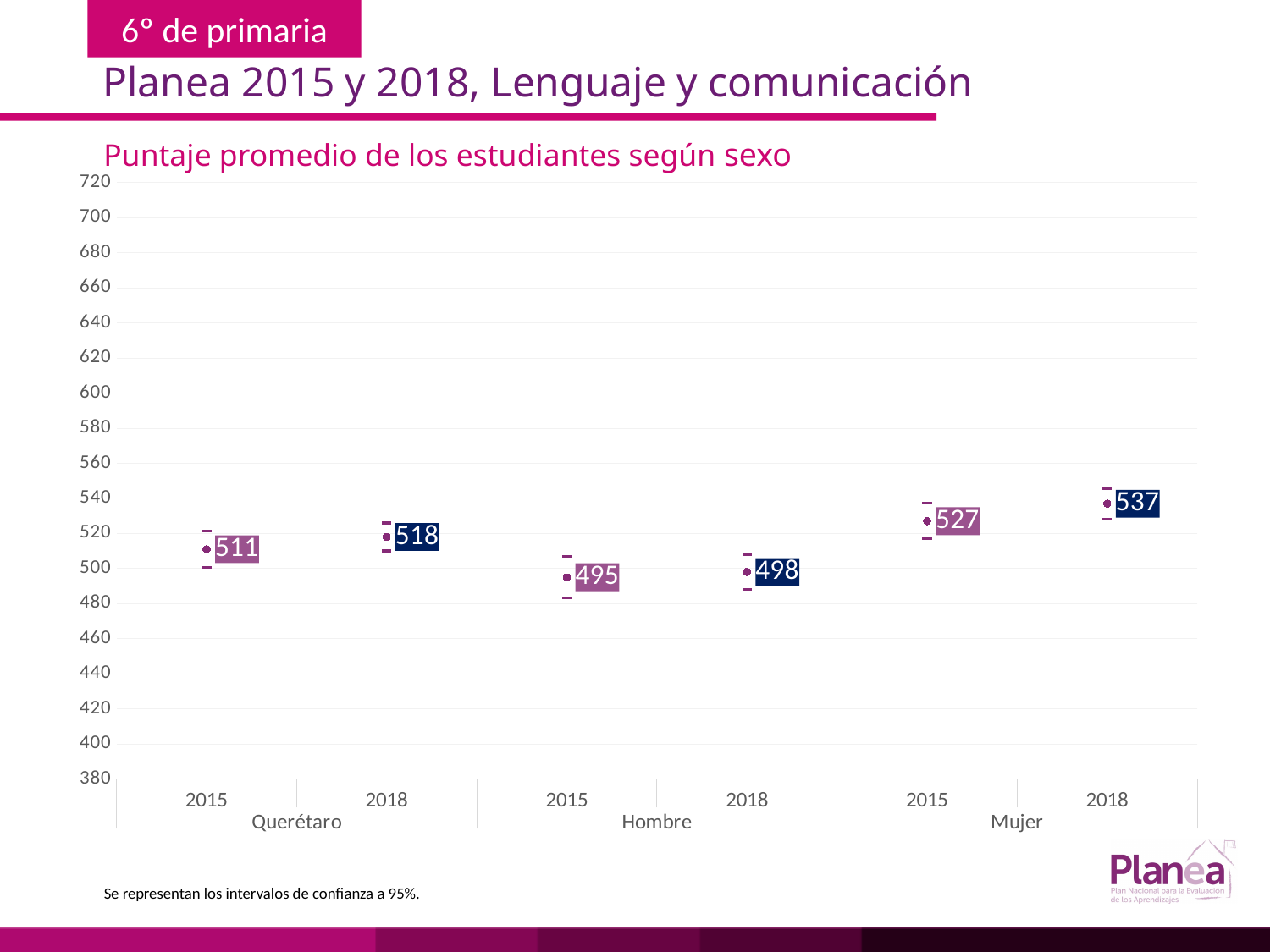
What is the average score for Mujer in 2018? 537 Which group and year has the lowest average score? Hombre 2015 What is the difference between the Mujer scores in 2018 and 2015? 10 Do the scores rise or fall from 2015 to 2018 for each group? rise Is the value for Hombre in 2015 greater or less than 500? less What is the title of the chart? Puntaje promedio de los estudiantes según sexo What is the average score for Hombre in 2018? 498 Which is larger, the Mujer score in 2015 or the Querétaro score in 2018? Mujer 2015 What is the difference between the Querétaro scores in 2018 and 2015? 7 How many data points are plotted on the chart? 6 What is the average score for Querétaro in 2015? 511 Which group and year has the highest average score? Mujer 2018